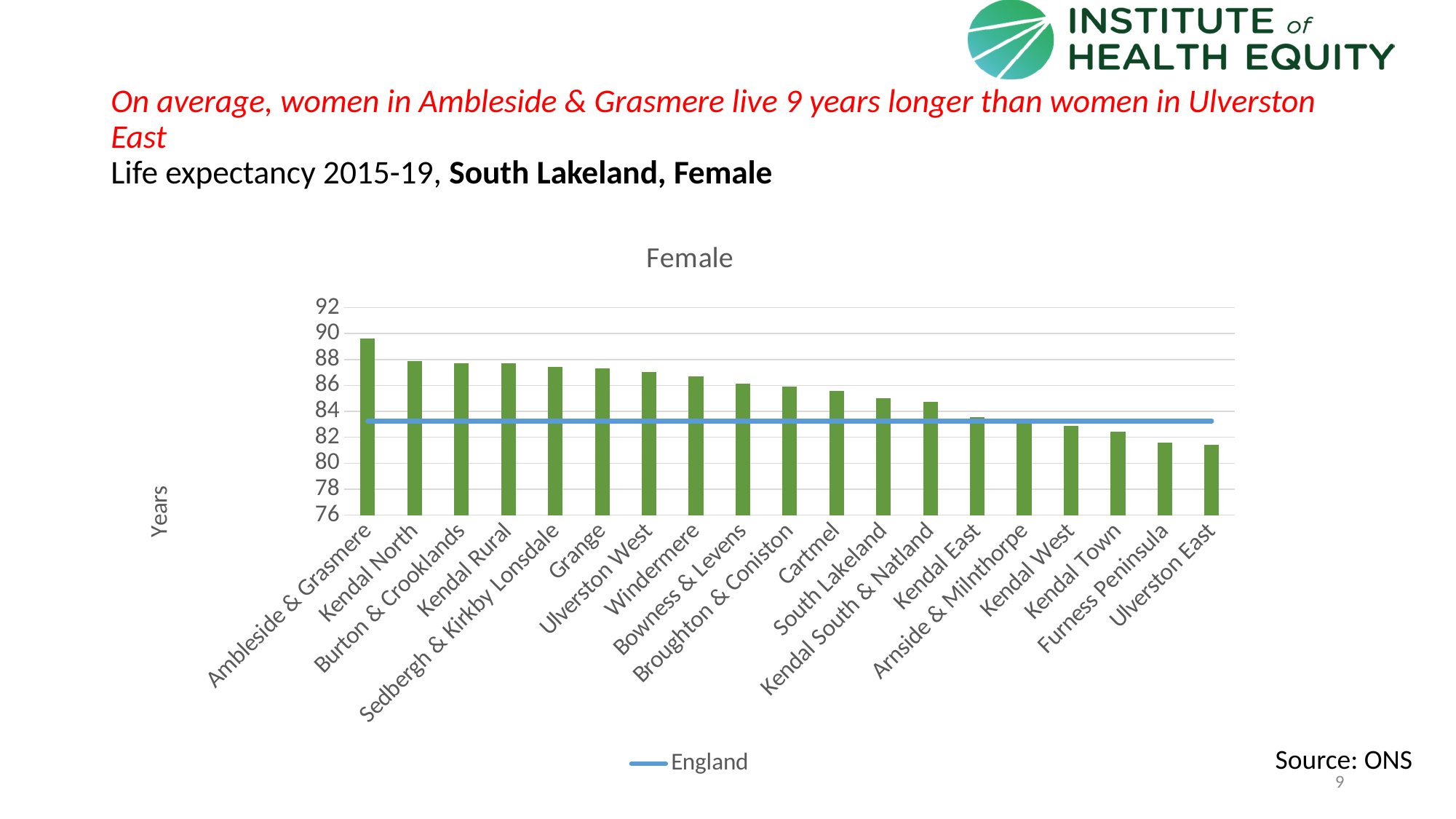
Is the value for Ulverston East greater or less than 82? less Which area has the highest female life expectancy in the chart? Ambleside & Grasmere Is the value for Kendal Town greater or less than 84? less What is the label on the vertical axis of the chart? Years Is the value for Ambleside & Grasmere greater or less than 88? greater Which is larger, the value for Kendal North or the value for Kendal Town? Kendal North What entry does the chart legend list? England Do the bar values rise or fall from left to right along the x axis? fall How many areas are plotted as bars in the chart? 19 What kind of chart is shown on the slide? bar chart Which area has the lowest female life expectancy in the chart? Ulverston East